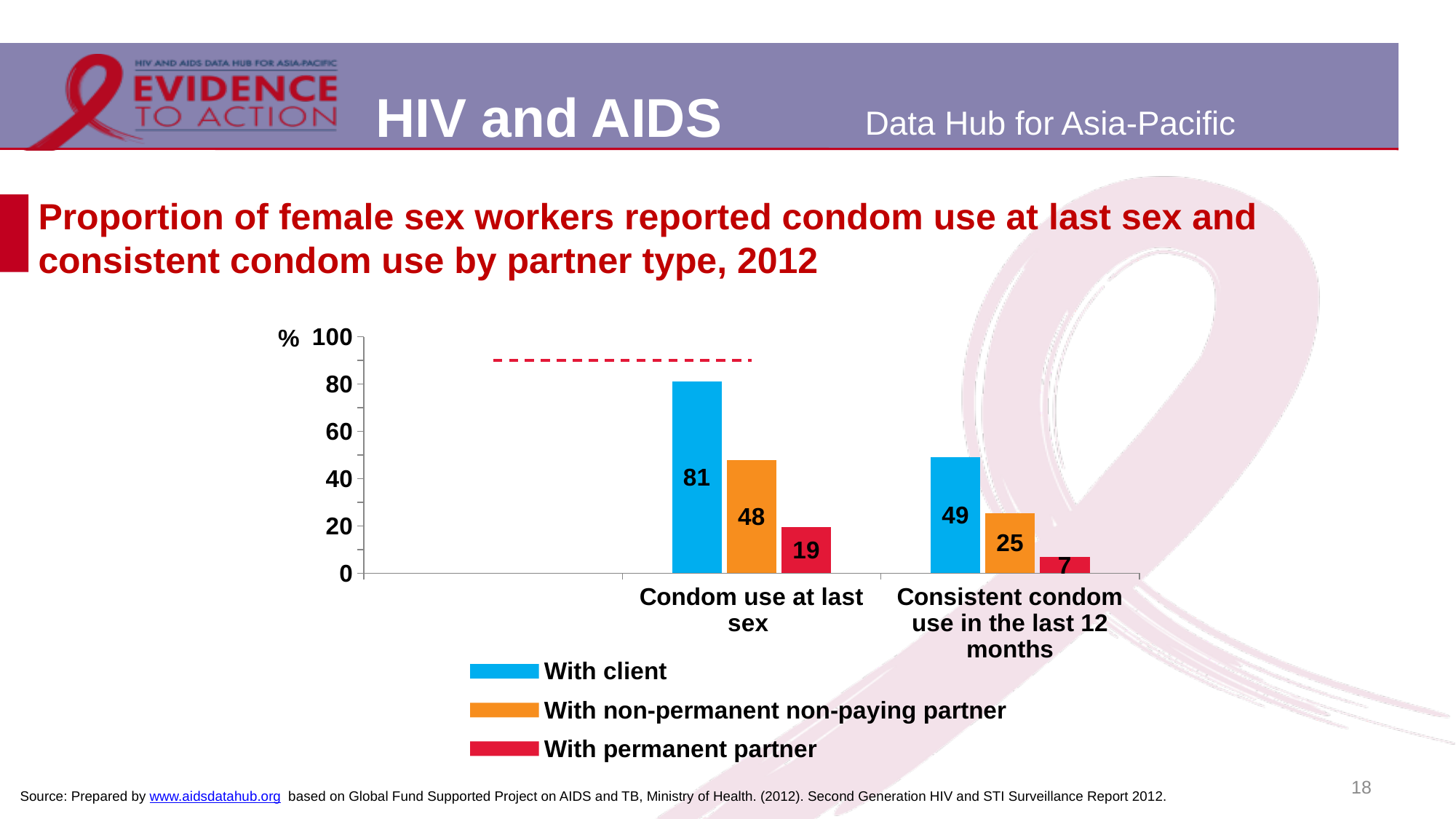
How many series does the legend list? 3 What is the value for 'With non-permanent non-paying partner' in the 'Condom use at last sex' category? 48 Which series has the lowest value in the 'Condom use at last sex' category? With permanent partner What is the difference between 'With non-permanent non-paying partner' and 'With permanent partner' in the 'Consistent condom use in the last 12 months' category? 18 Is the value for 'With client' in 'Condom use at last sex' greater or less than 60? greater Which is larger: 'With non-permanent non-paying partner' for 'Condom use at last sex' or 'With client' for 'Consistent condom use in the last 12 months'? With client for Consistent condom use in the last 12 months What is the difference between the 'With client' values for 'Condom use at last sex' and 'Consistent condom use in the last 12 months'? 32 What is the value for 'With permanent partner' in the 'Consistent condom use in the last 12 months' category? 7 How many categories are shown on the x axis? 2 What is the value for 'With client' in the 'Condom use at last sex' category? 81 Which series has the highest value in the 'Consistent condom use in the last 12 months' category? With client What kind of chart is shown on the slide? Bar chart